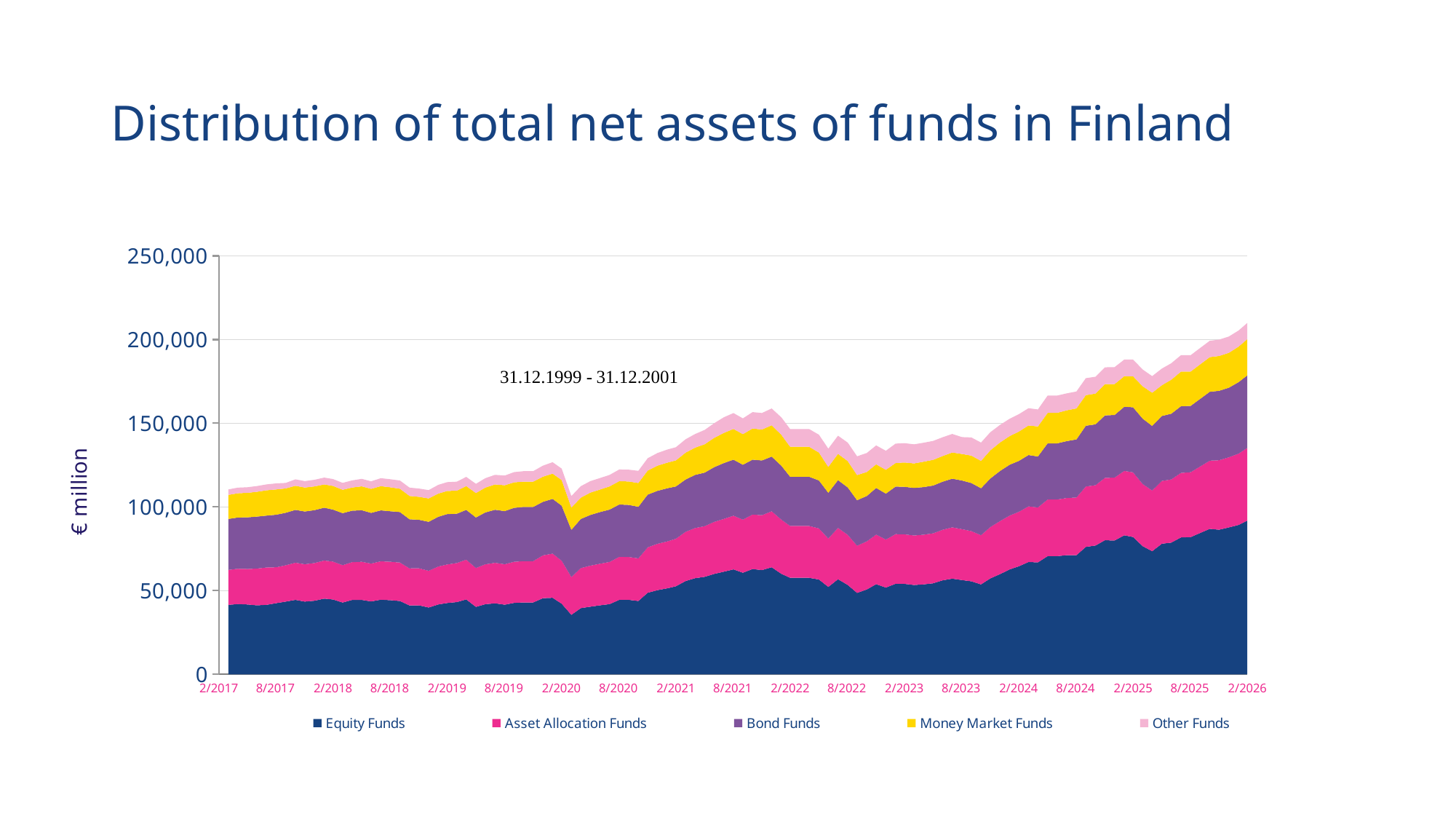
Which fund type has the smallest net assets at 2/2026? Other Funds How many series does the legend list? 5 Is the total net assets of all funds at 2/2026 greater or less than 200,000? greater Does the total net assets of funds rise or fall overall from 2/2017 to 2/2026? rise Is the value for Equity Funds at 2/2017 greater or less than 50,000? less What kind of chart is shown on the slide? Stacked area chart Which is larger at 2/2026: Equity Funds or Money Market Funds? Equity Funds What is the label on the vertical axis? € million Is the value for Equity Funds at 2/2026 greater or less than 50,000? greater Which series is shown at the bottom of the stack in dark blue? Equity Funds What is the title of the chart? Distribution of total net assets of funds in Finland Which fund type has the largest net assets at 2/2026? Equity Funds